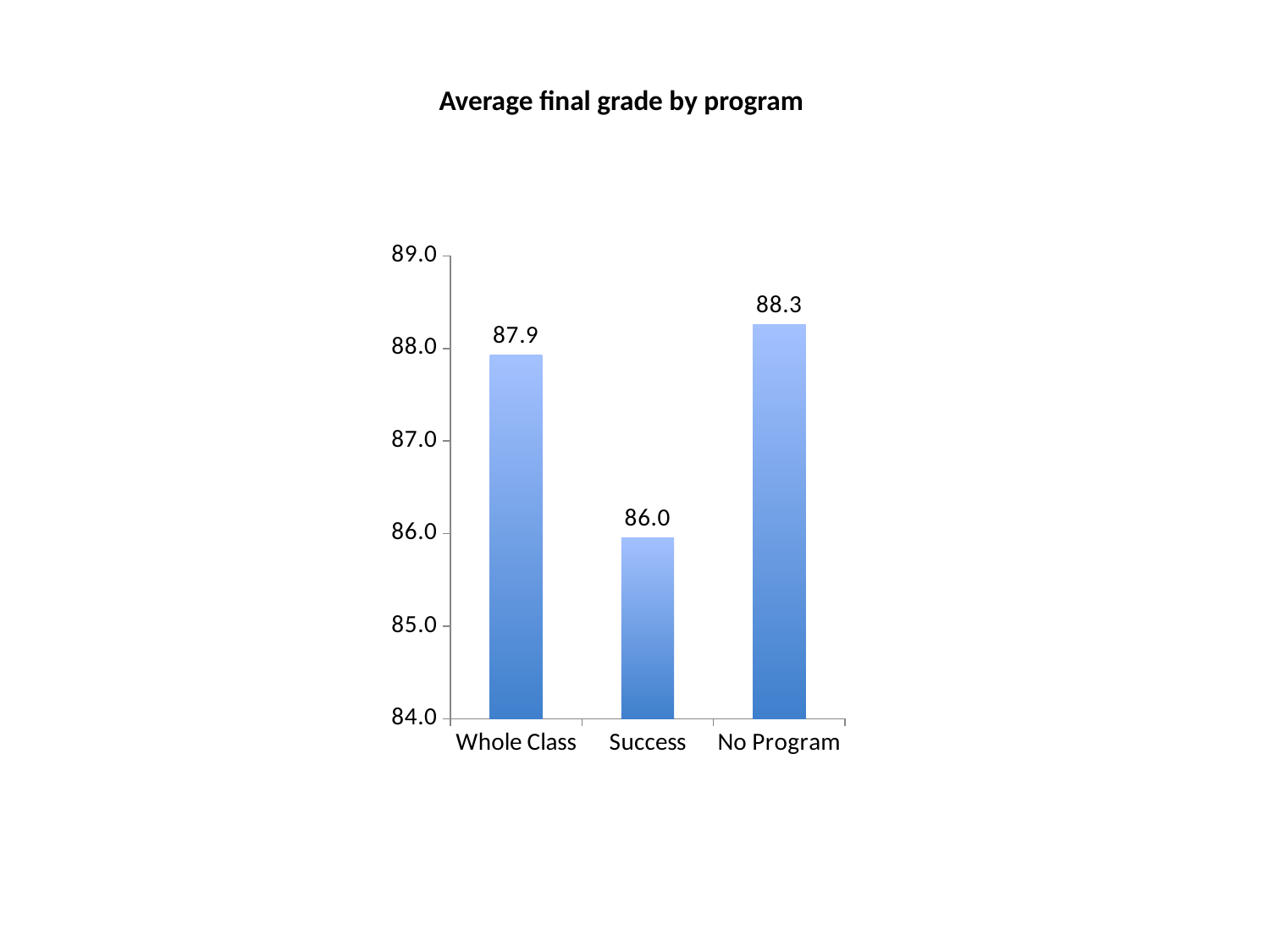
Which has a higher average final grade, Whole Class or Success? Whole Class What is the average final grade for Success? 86.0 What is the difference between the average final grade for No Program and Success? 2.3 What is the average final grade for No Program? 88.3 What is the title of the chart? Average final grade by program What is the difference between the average final grade for Whole Class and Success? 1.9 What is the average final grade for Whole Class? 87.9 Which program has the lowest average final grade? Success What kind of chart is shown on the slide? Bar chart Is the value for Success greater or less than 87.0? less Which program has the highest average final grade? No Program How many programs are shown on the chart? 3